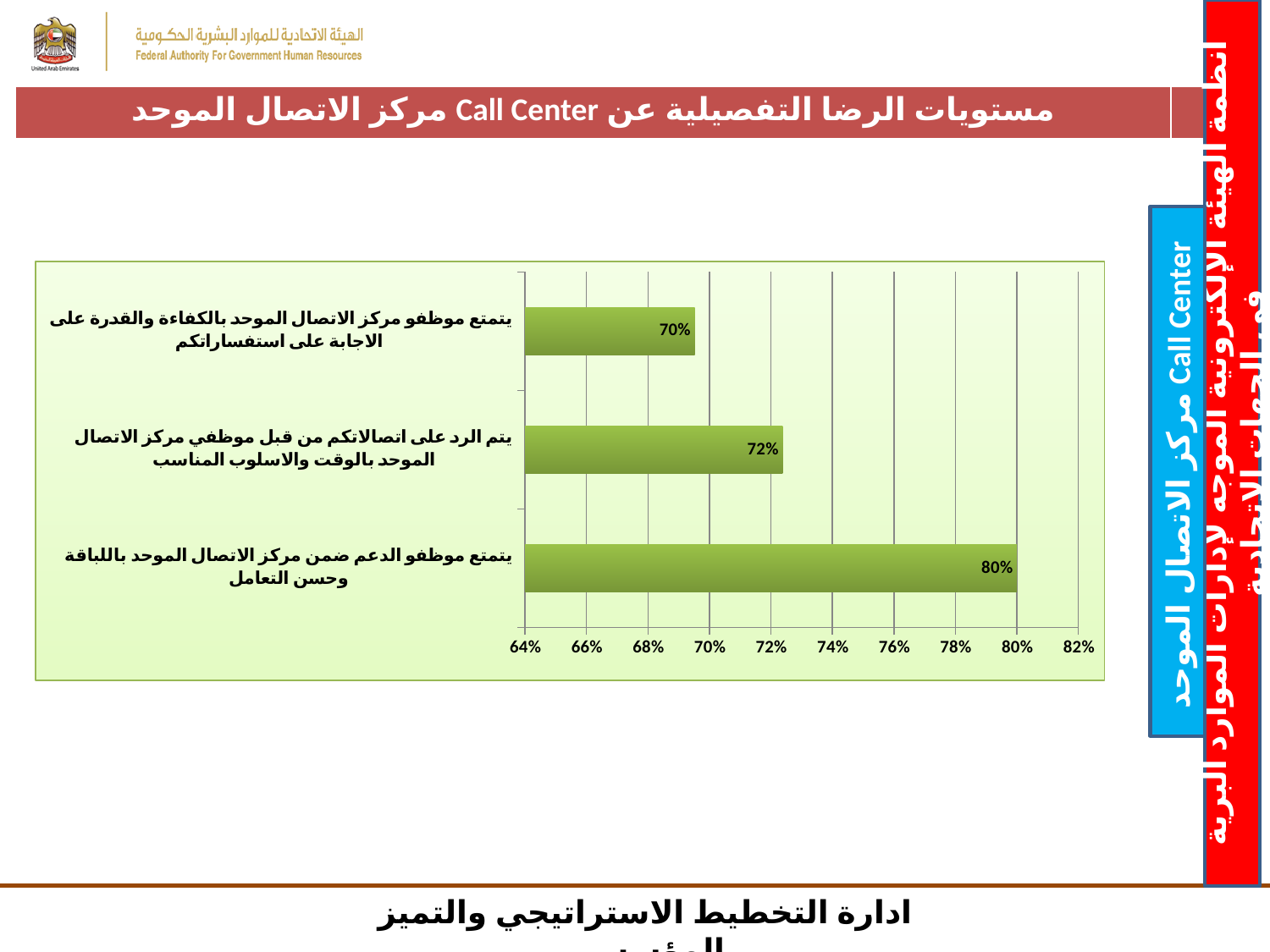
Which category has the lowest value? يتمتع موظفو مركز الاتصال الموحد بالكفاءة والقدرة على الاجابة على استفساراتكم Is the value for "يتمتع موظفو الدعم ضمن مركز الاتصال الموحد باللباقة وحسن التعامل" greater or less than 76%? greater What is the value for the category "يتمتع موظفو مركز الاتصال الموحد بالكفاءة والقدرة على الاجابة على استفساراتكم"? 70% What is the difference between the value for "يتم الرد على اتصالاتكم من قبل موظفي مركز الاتصال الموحد بالوقت والاسلوب المناسب" and the value for "يتمتع موظفو مركز الاتصال الموحد بالكفاءة والقدرة على الاجابة على استفساراتكم"? 2% What is the value for the category "يتم الرد على اتصالاتكم من قبل موظفي مركز الاتصال الموحد بالوقت والاسلوب المناسب"? 72% Which is larger: the value for "يتم الرد على اتصالاتكم من قبل موظفي مركز الاتصال الموحد بالوقت والاسلوب المناسب" or the value for "يتمتع موظفو مركز الاتصال الموحد بالكفاءة والقدرة على الاجابة على استفساراتكم"? يتم الرد على اتصالاتكم من قبل موظفي مركز الاتصال الموحد بالوقت والاسلوب المناسب What is the difference between the highest value (80%) and the lowest value (70%)? 10% What kind of chart is shown on the slide? bar chart What is the value for the category "يتمتع موظفو الدعم ضمن مركز الاتصال الموحد باللباقة وحسن التعامل"? 80% Which category has the highest value? يتمتع موظفو الدعم ضمن مركز الاتصال الموحد باللباقة وحسن التعامل How many categories are shown in the chart? 3 What is the title of the slide containing the chart? مستويات الرضا التفصيلية عن Call Center مركز الاتصال الموحد